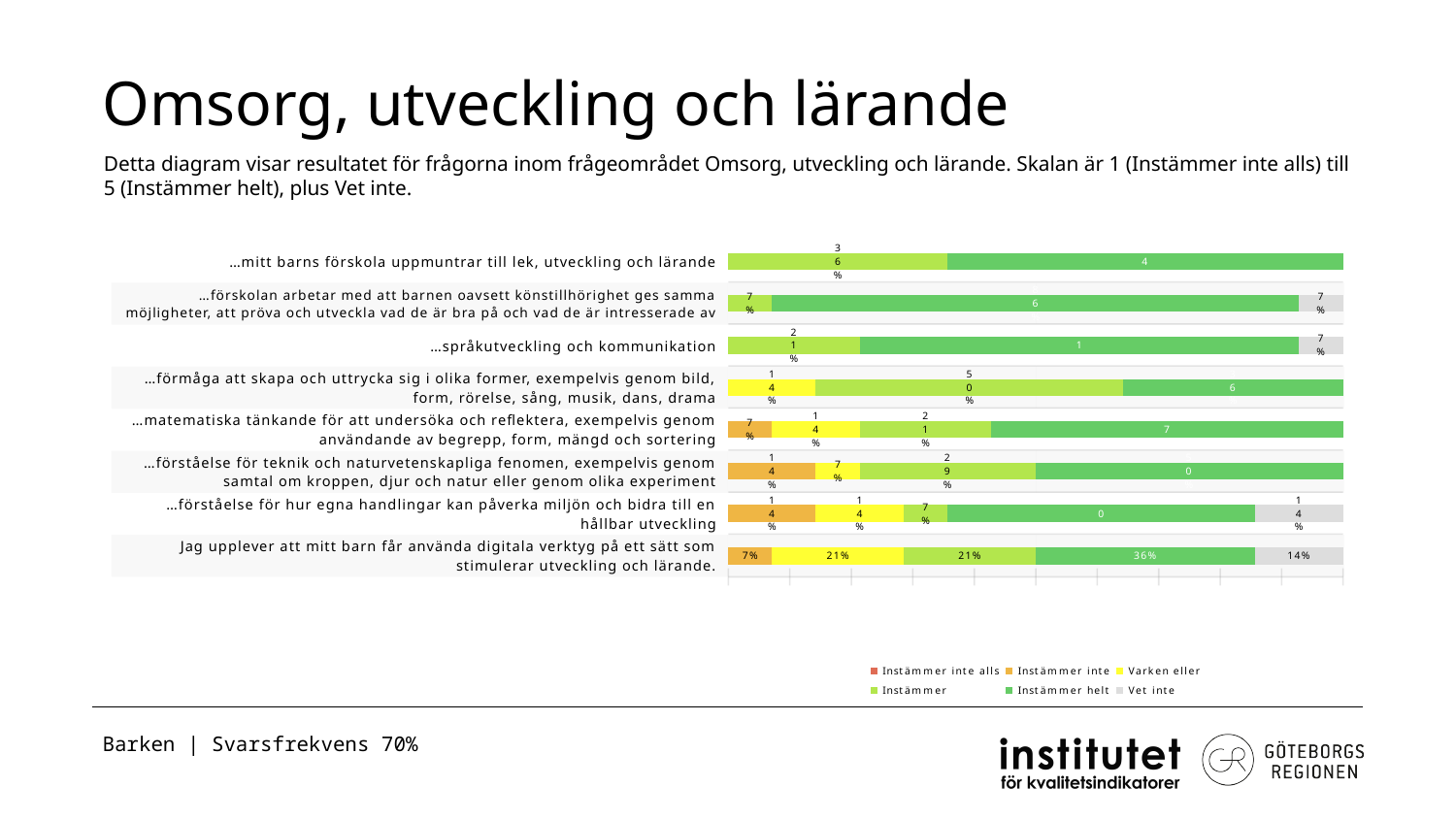
For the statement 'Jag upplever att mitt barn får använda digitala verktyg på ett sätt som stimulerar utveckling och lärande.', what is the value for Instämmer helt? 36% For the statement 'Jag upplever att mitt barn får använda digitala verktyg på ett sätt som stimulerar utveckling och lärande.', what is the value for Varken eller? 21% What kind of chart is shown on the slide? Stacked bar chart For the statement 'Jag upplever att mitt barn får använda digitala verktyg på ett sätt som stimulerar utveckling och lärande.', what is the value for Vet inte? 14% What colour represents Vet inte in the legend? Grey For the statement 'Jag upplever att mitt barn får använda digitala verktyg...', what is the difference between Instämmer helt and Vet inte? 22% How many series does the legend list? 6 How many statements (bars) are plotted in the chart? 8 For the statement 'Jag upplever att mitt barn får använda digitala verktyg på ett sätt som stimulerar utveckling och lärande.', what is the value for Instämmer inte? 7% Which statement has the largest Instämmer helt segment? …förskolan arbetar med att barnen oavsett könstillhörighet ges samma möjligheter, att pröva och utveckla vad de är bra på och vad de är intresserade av For the statement 'Jag upplever att mitt barn får använda digitala verktyg...', which is larger: Instämmer helt or Varken eller? Instämmer helt For the statement '…förskolan arbetar med att barnen oavsett könstillhörighet ges samma möjligheter…', what is the value for Vet inte? 7%